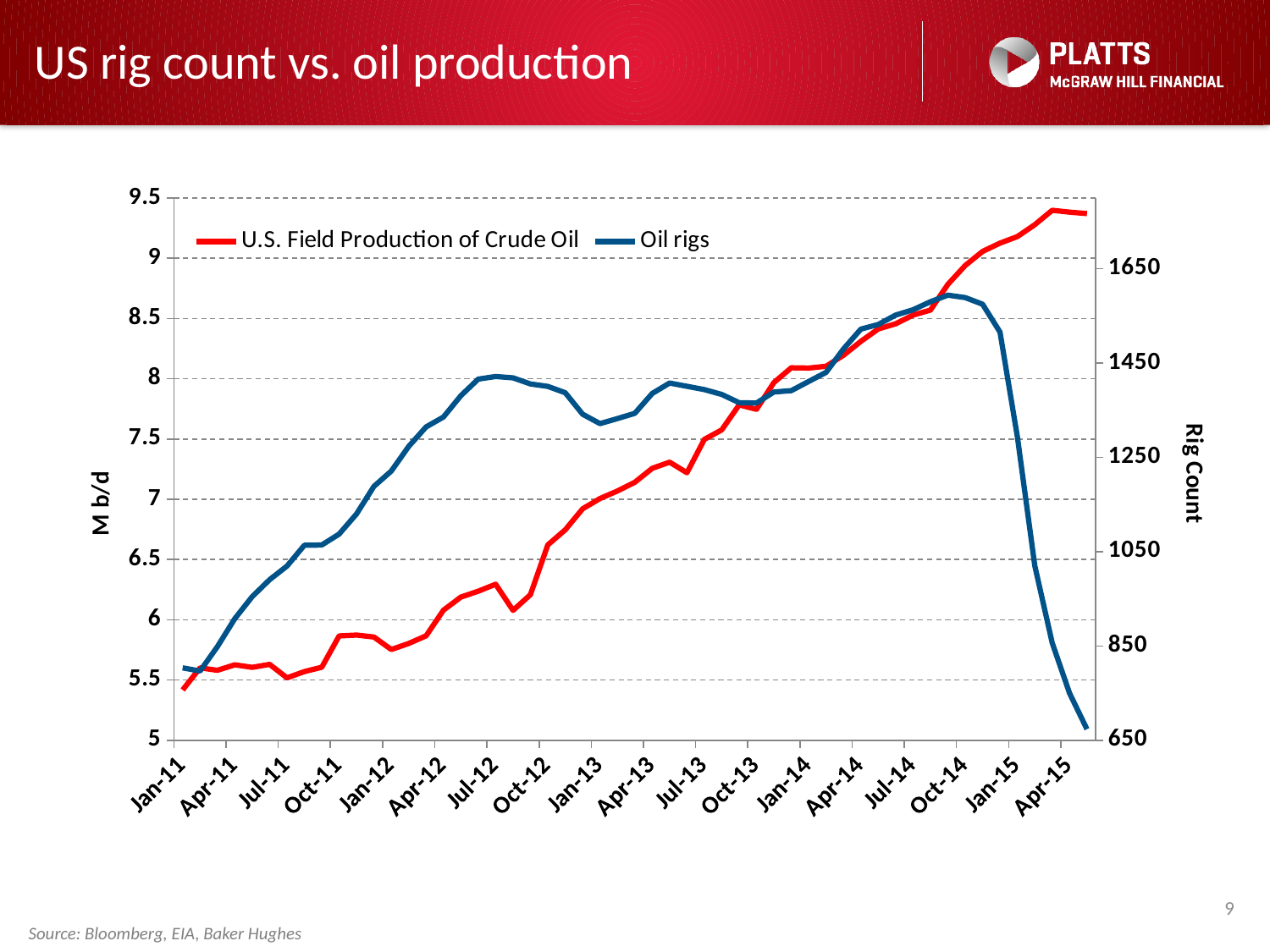
Is the value for Oil rigs at Jul-12 greater or less than 1250? greater What kind of chart is shown on the slide? Line chart What are the two series named in the legend? U.S. Field Production of Crude Oil and Oil rigs Does U.S. Field Production of Crude Oil generally rise or fall from Jan-11 to Apr-15? rise Is the value for Oil rigs at Apr-15 greater or less than 850? less Is the value for U.S. Field Production of Crude Oil at Jul-12 greater or less than 6.5? less How many series does the legend list? 2 What is the title of the left vertical axis? M b/d Does the Oil rigs series rise or fall between Oct-14 and Apr-15? fall Around which x-axis label does the Oil rigs series reach its highest value? Oct-14